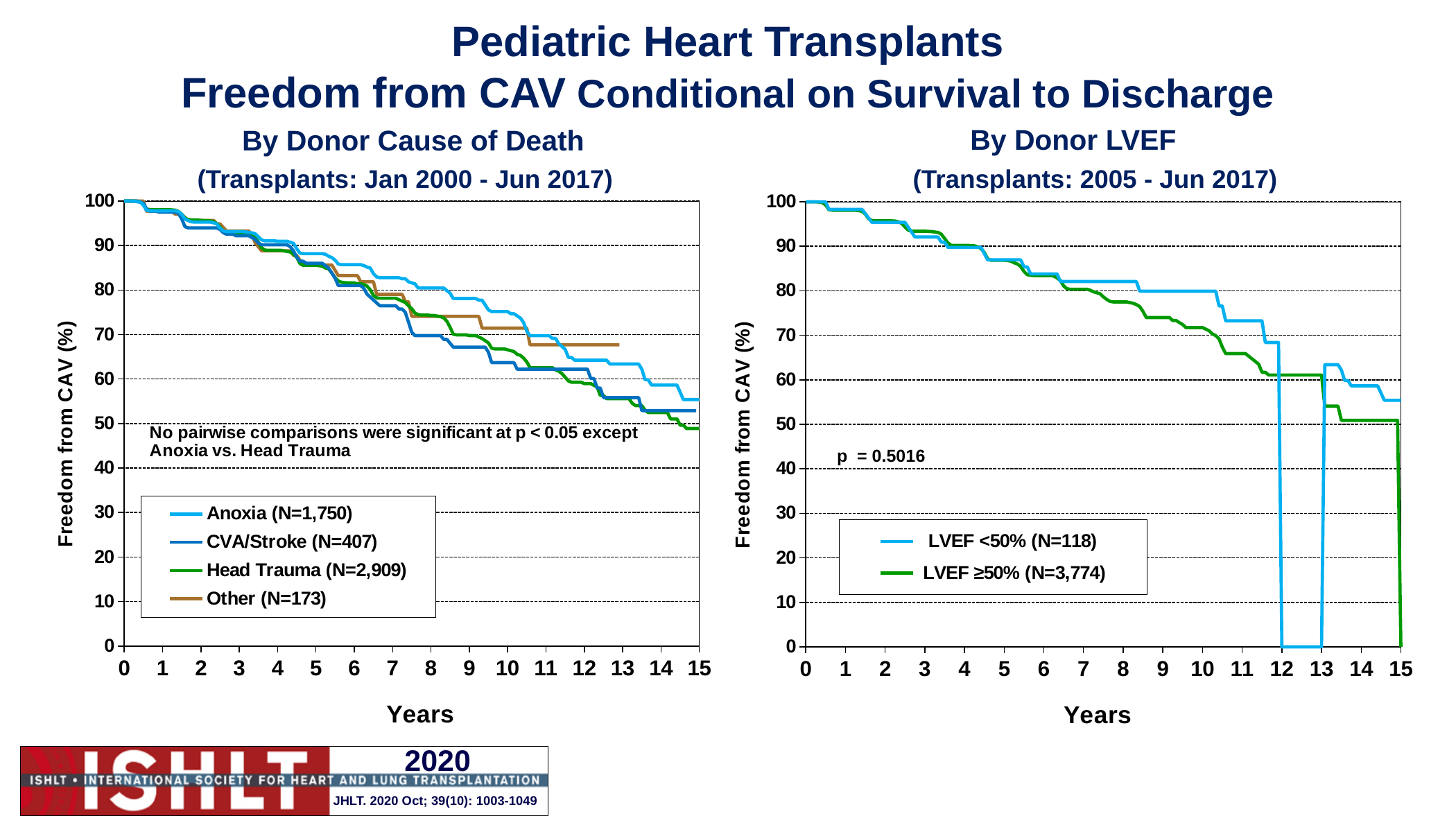
How many series does the legend of the left chart, 'By Donor Cause of Death', list? 4 In the right chart, 'By Donor LVEF', is the value for LVEF <50% at year 5 greater or less than 80? greater In the left chart, 'By Donor Cause of Death', what is the N for Head Trauma shown in the legend? 2,909 What kind of chart is the left chart, 'By Donor Cause of Death'? line chart What p-value is shown on the right chart, 'By Donor LVEF'? p = 0.5016 In the left chart, 'By Donor Cause of Death', is the value for Head Trauma at year 10 greater or less than 70? less In the right chart, 'By Donor LVEF', is the value for LVEF ≥50% at year 8 greater or less than 80? less In the right chart, 'By Donor LVEF', do the values for LVEF ≥50% rise or fall as years increase? fall How many series does the legend of the right chart, 'By Donor LVEF', list? 2 In the left chart, 'By Donor Cause of Death', do the values for Anoxia rise or fall as years increase? fall